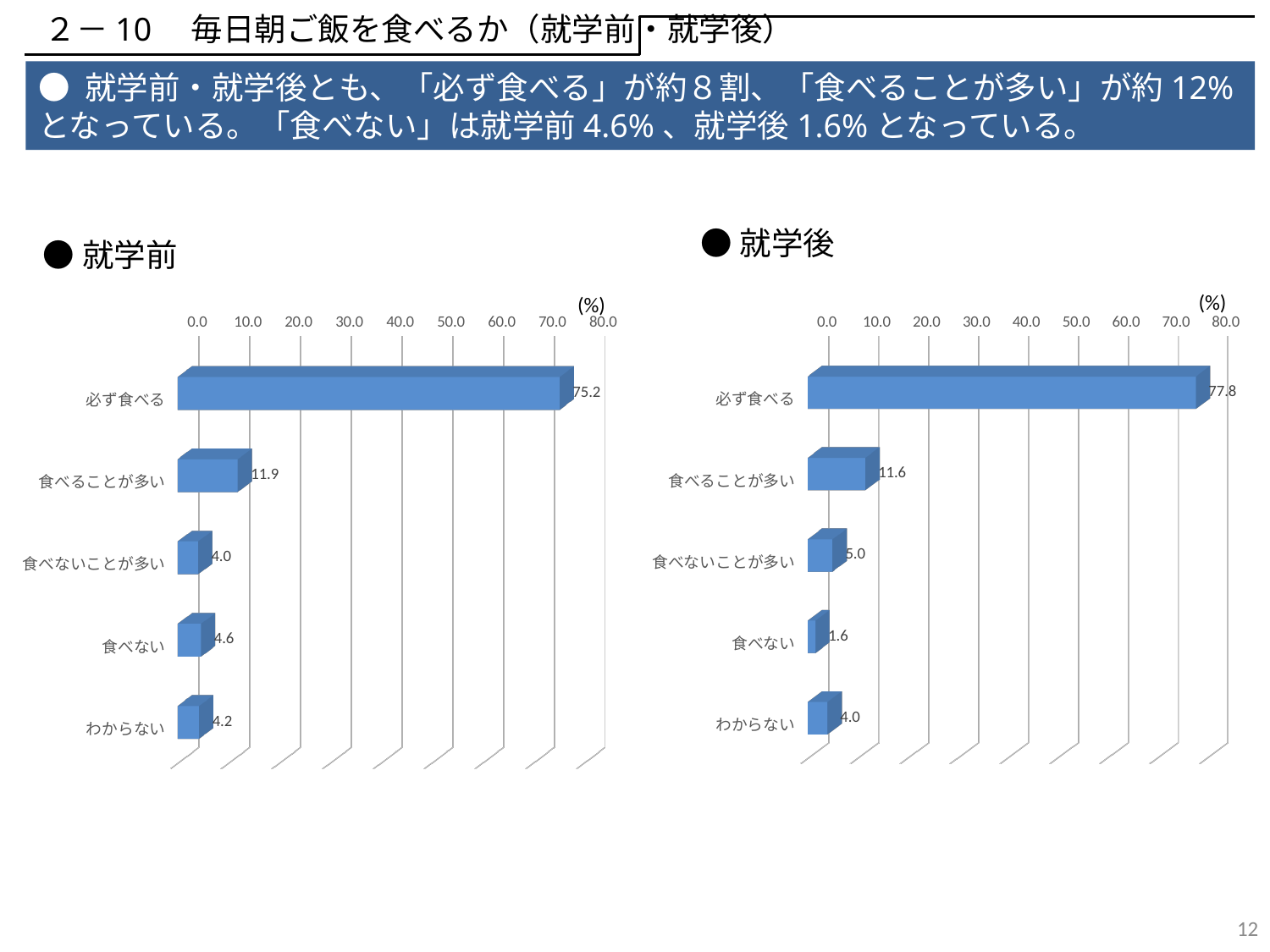
What unit is shown at the top of the axis in the 就学前 chart? (%) In the 就学前 chart, what is the value for 必ず食べる? 75.2 In the 就学後 chart, what is the value for 食べない? 1.6 How many categories does the 就学前 chart show? 5 What kind of chart is the 就学後 chart? bar chart In the 就学前 chart, which category has the lowest value? 食べないことが多い In the 就学前 chart, which is larger, 食べない or わからない? 食べない What is the difference between the 必ず食べる values in the 就学後 chart and the 就学前 chart? 2.6 In the 就学後 chart, which category has the lowest value? 食べない In the 就学前 chart, what is the value for 食べることが多い? 11.9 In the 就学後 chart, what is the value for 食べないことが多い? 5.0 In the 就学後 chart, which category has the highest value? 必ず食べる